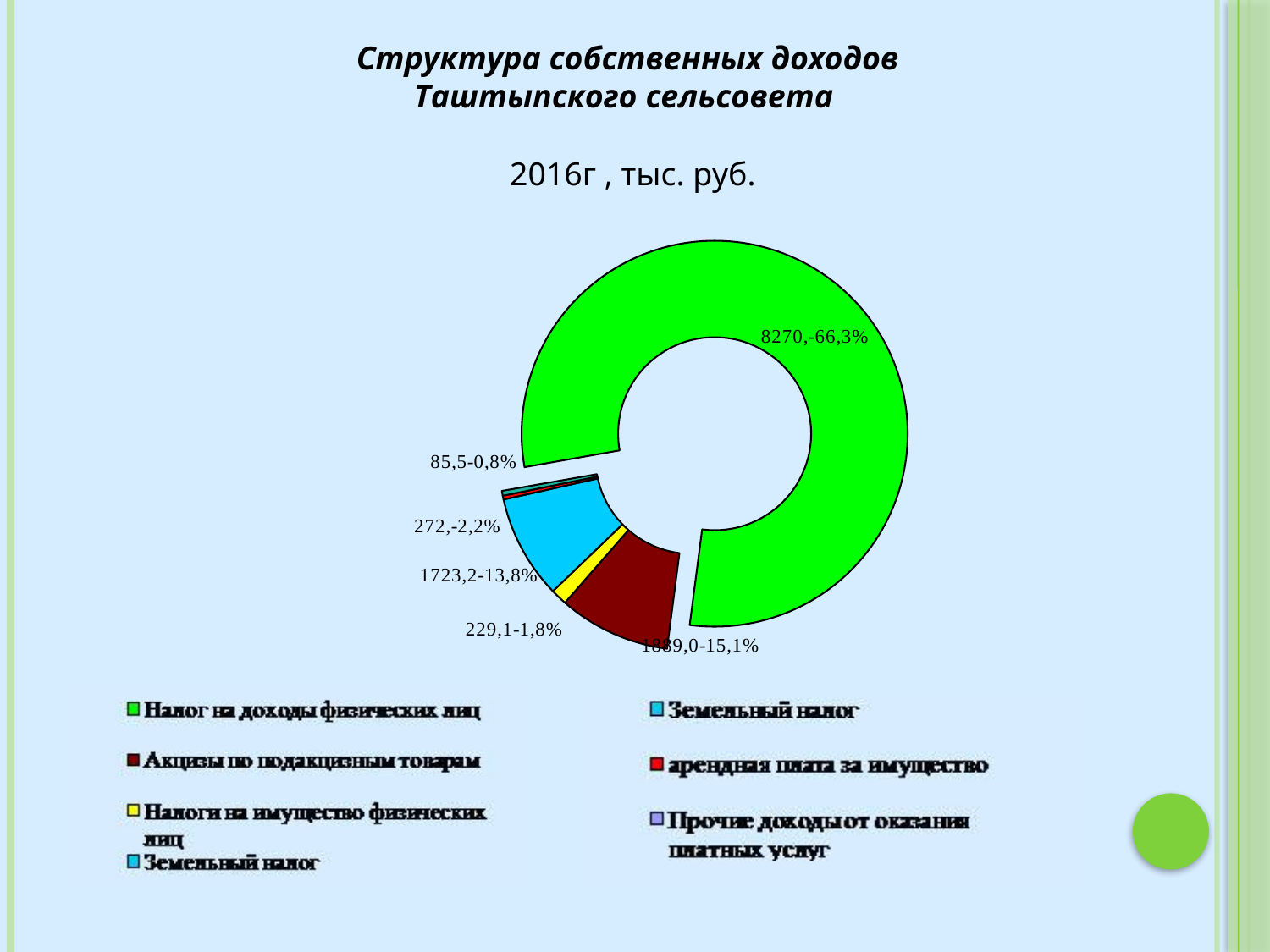
What is the value for Налог на доходы физических лиц? 8270 What is the value for Земельный налог? 1723,2 What is the difference between the values for Налог на доходы физических лиц and Земельный налог? 6546,8 What year and units are stated under the chart title? 2016г, тыс. руб. Which category has the largest slice? Налог на доходы физических лиц What share of the total does Акцизы по подакцизным товарам represent? 15,1% What is the value for Налоги на имущество физических лиц? 229,1 What share of the total does Налог на доходы физических лиц represent? 66,3% What kind of chart is shown on the slide? doughnut chart How many slices does the chart have? 6 Which is larger: Земельный налог or Налоги на имущество физических лиц? Земельный налог What share of the total does Земельный налог represent? 13,8%